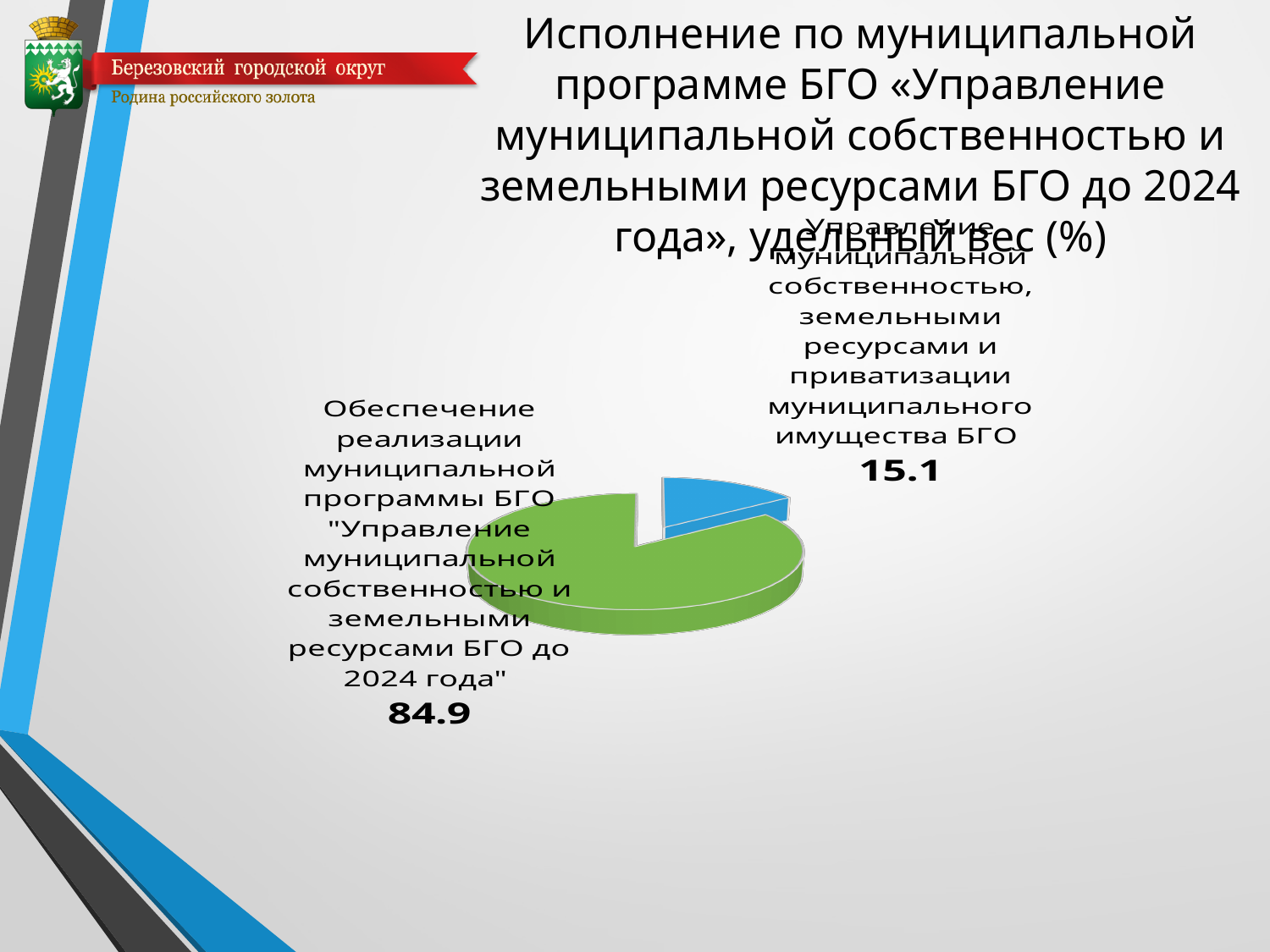
How many slices does the pie chart have? 2 Which slice of the pie chart is the smallest? Управление муниципальной собственностью, земельными ресурсами и приватизации муниципального имущества БГО What share of the pie does the "Управление муниципальной собственностью, земельными ресурсами и приватизации муниципального имущества БГО" slice represent? 15.1% What is the value shown for the slice "Управление муниципальной собственностью, земельными ресурсами и приватизации муниципального имущества БГО"? 15.1 What colour is the slice labelled 15.1? blue What is the value shown for the slice "Обеспечение реализации муниципальной программы БГО"? 84.9 What type of chart is shown on the slide? pie chart Which slice of the pie chart is the largest? Обеспечение реализации муниципальной программы БГО What is the difference between the values of the two slices (84.9 and 15.1)? 69.8 Which is larger: the value for "Обеспечение реализации муниципальной программы БГО" or the value for "Управление муниципальной собственностью, земельными ресурсами и приватизации муниципального имущества БГО"? Обеспечение реализации муниципальной программы БГО What colour is the slice labelled 84.9? green What is the total of the two slice values shown on the pie chart? 100